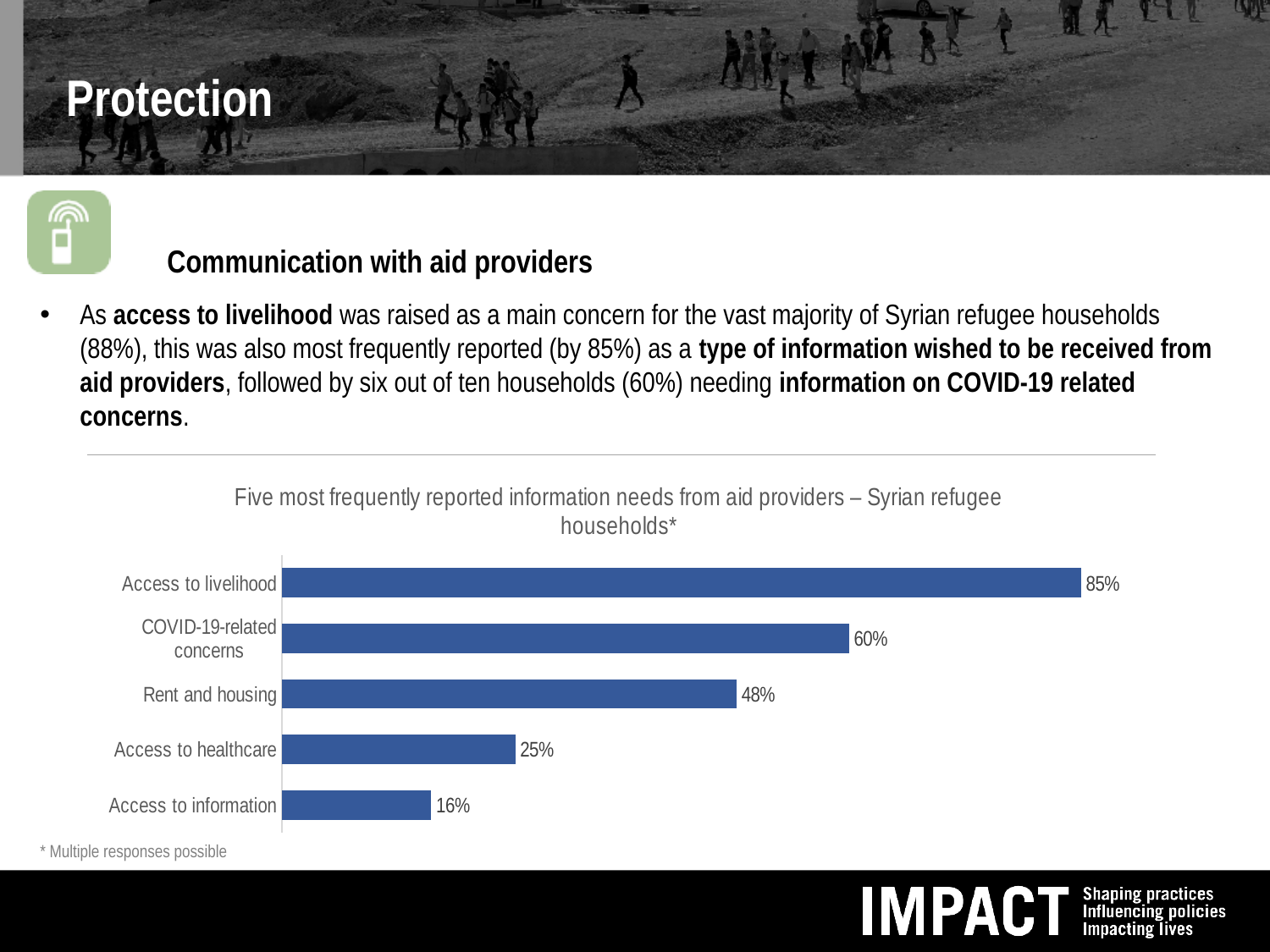
What type of chart is used to show the information needs? Bar chart What is the title of the chart? Five most frequently reported information needs from aid providers – Syrian refugee households* What is the value shown for COVID-19-related concerns? 60% What percentage of Syrian refugee households reported access to livelihood as an information need from aid providers? 85% Which information need has the lowest reported percentage? Access to information What is the difference in percentage points between Rent and housing and Access to healthcare? 23 Which is larger: the value for Access to healthcare or the value for Access to information? Access to healthcare What is the value shown for Rent and housing? 48% What is the value shown for Access to information? 16% What is the difference in percentage points between Access to livelihood and COVID-19-related concerns? 25 How many information needs are shown in the chart? 5 Which information need has the highest reported percentage? Access to livelihood